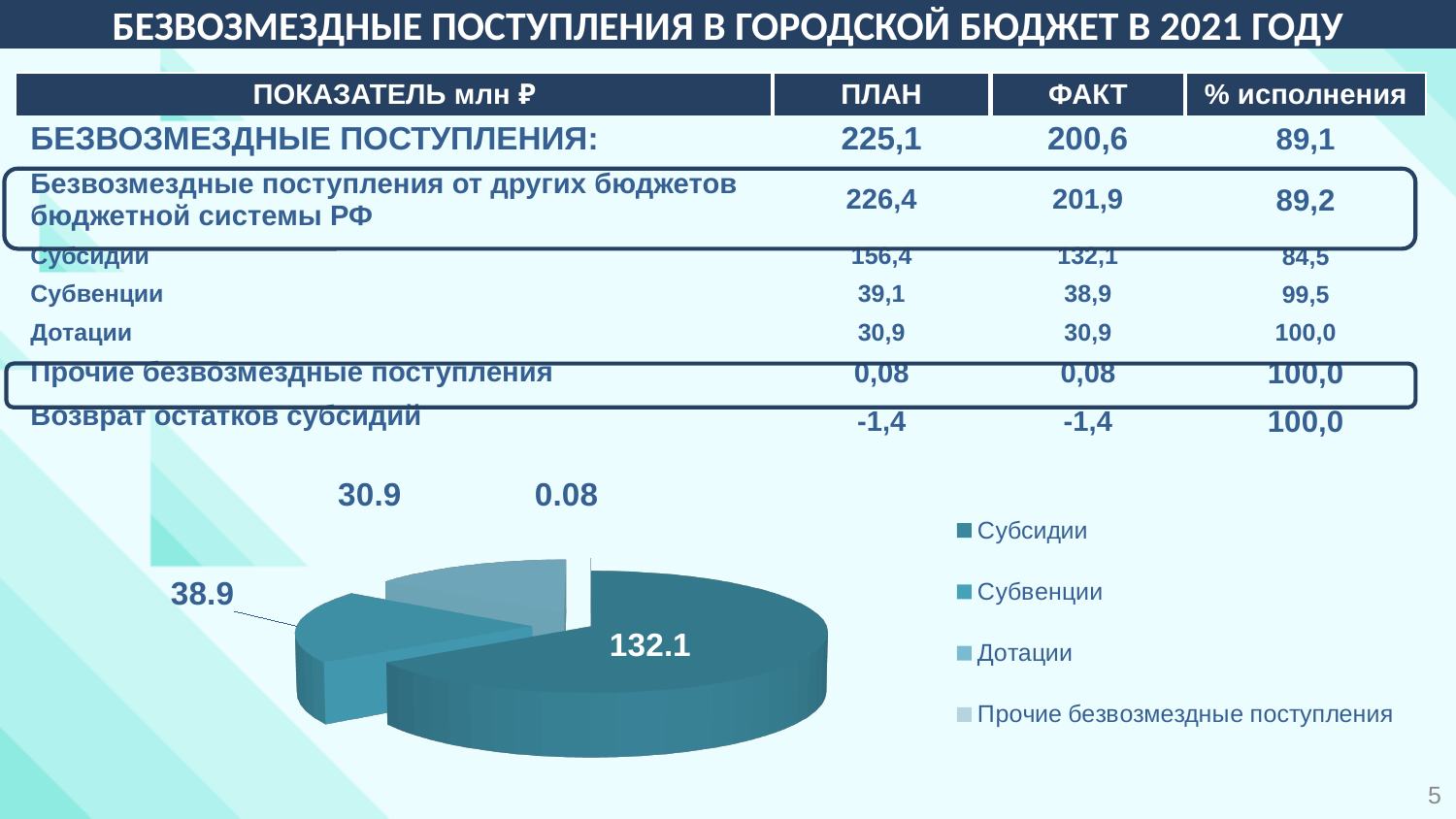
In the pie chart, what is the difference between the values for Субвенции and Дотации? 8.0 In the pie chart, what is the value for Прочие безвозмездные поступления? 0.08 Which category has the smallest slice in the pie chart? Прочие безвозмездные поступления In the pie chart, what is the value for Субсидии? 132.1 In the pie chart, which is larger: Субвенции or Дотации? Субвенции In the pie chart, what is the value for Дотации? 30.9 What kind of chart is shown on the slide? pie chart How many slices does the pie chart have? 4 Which category has the largest slice in the pie chart? Субсидии In the pie chart, what is the difference between the values for Субсидии and Субвенции? 93.2 In the pie chart, what is the value for Субвенции? 38.9 How many entries does the pie chart legend list? 4